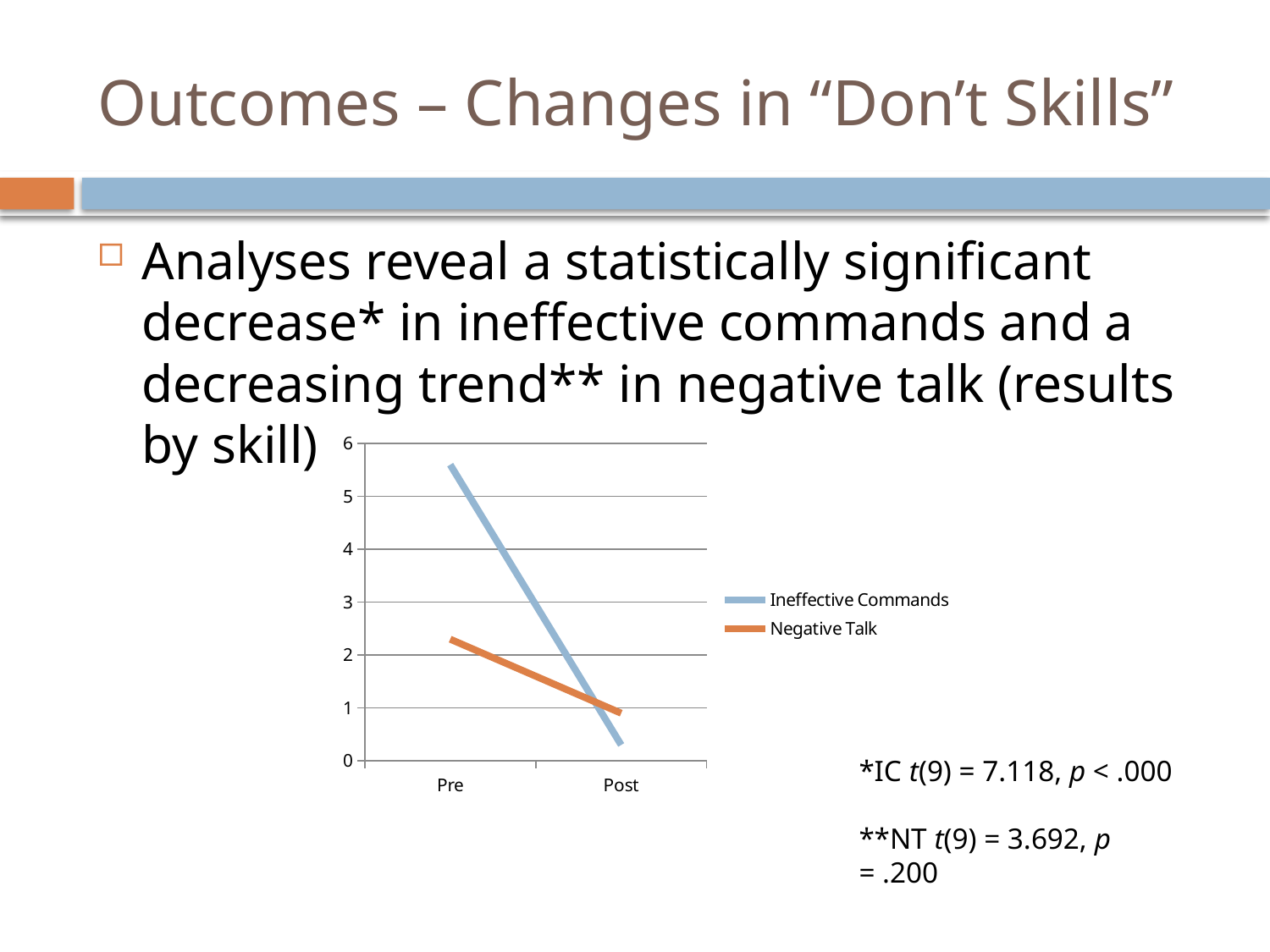
Is the value for Negative Talk at Pre greater or less than 2? greater What are the two categories on the x axis of the chart? Pre and Post What kind of chart is shown on the slide? line chart Is the value for Ineffective Commands at Pre greater or less than 5? greater Is the value for Ineffective Commands at Post greater or less than 1? less Does the Ineffective Commands line rise or fall from Pre to Post? fall At Post, which series has the higher value, Ineffective Commands or Negative Talk? Negative Talk How many series does the chart's legend list? 2 How many categories are shown on the x axis of the chart? 2 Which series is drawn in orange in the chart? Negative Talk Does the Negative Talk line rise or fall from Pre to Post? fall At Pre, which series has the higher value, Ineffective Commands or Negative Talk? Ineffective Commands